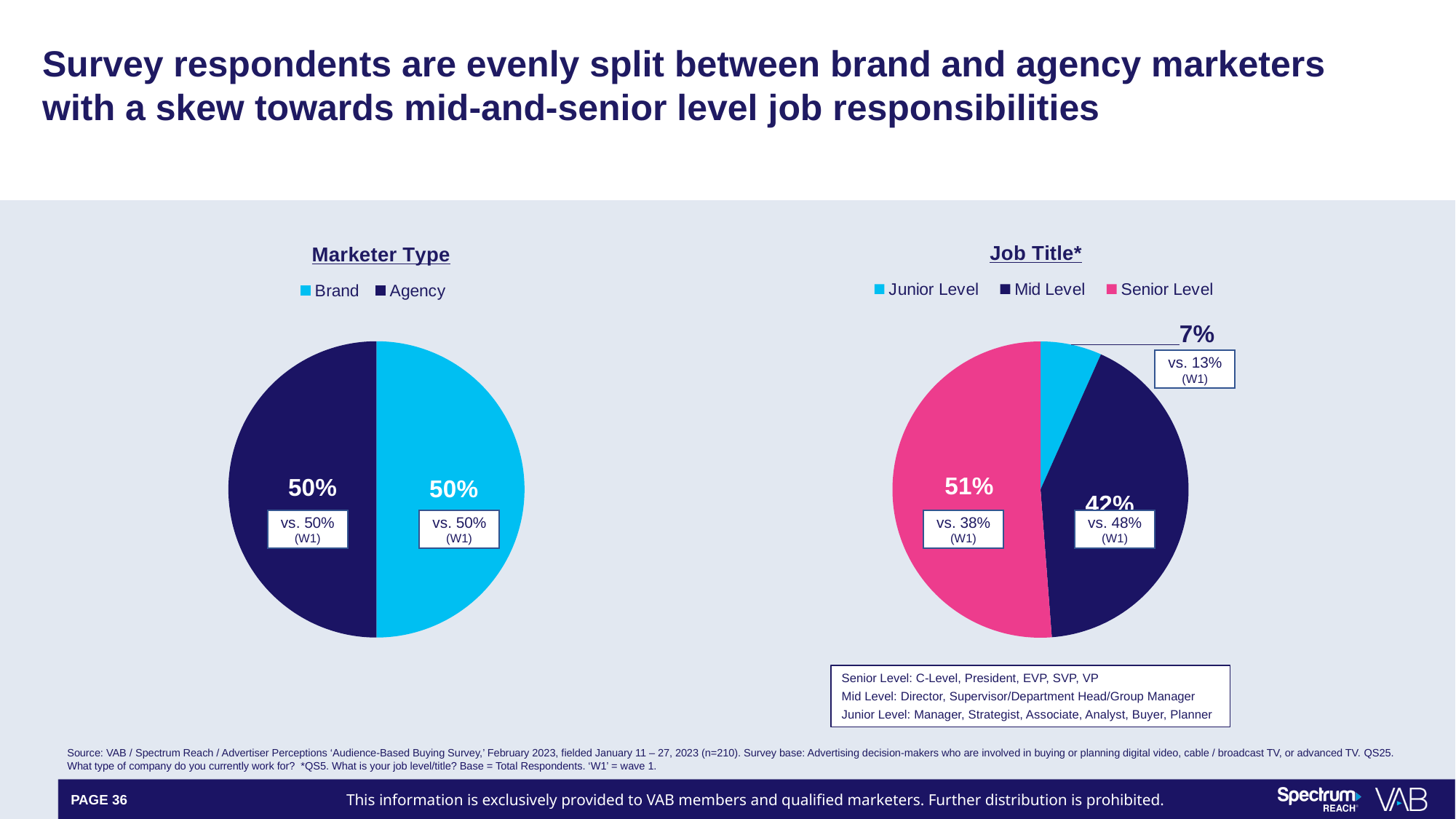
In the Job Title* chart, what share of respondents are Junior Level? 7% How many categories does the legend of the Job Title* chart list? 3 In the Job Title* chart, what is the difference between the Senior Level and Mid Level shares? 9 percentage points How many series does the legend of the Marketer Type chart list? 2 In the Marketer Type chart, what share of respondents are Brand marketers? 50% In the Marketer Type chart, what share of respondents are Agency marketers? 50% In the Job Title* chart, what share of respondents are Mid Level? 42% What kind of chart is the Marketer Type chart? Pie chart In the Job Title* chart, what was the Junior Level share in W1? 13% In the Job Title* chart, which job level has the largest share? Senior Level In the Job Title* chart, which job level has the smallest share? Junior Level In the Job Title* chart, what share of respondents are Senior Level? 51%